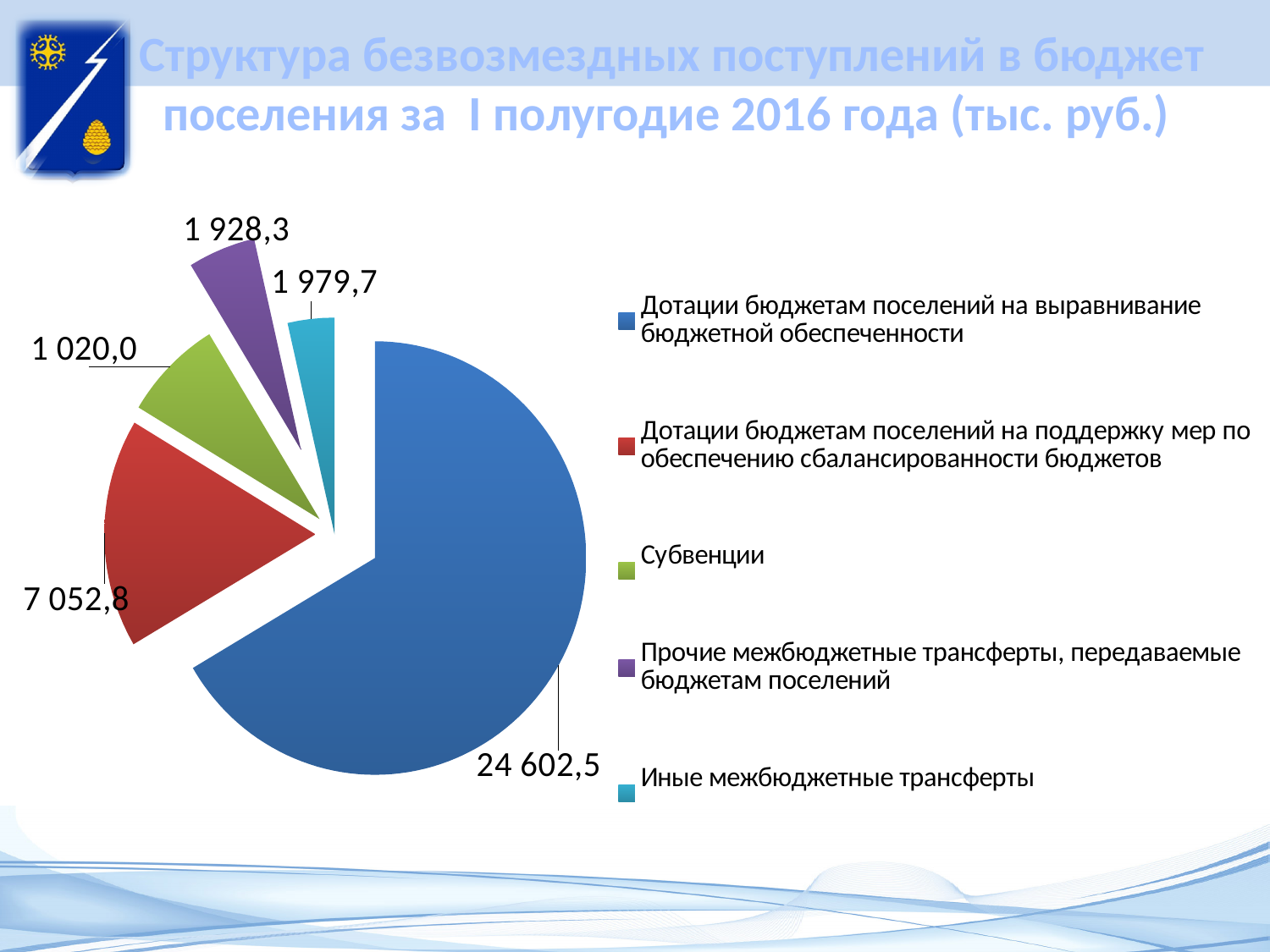
Which category has the largest slice of the pie? Дотации бюджетам поселений на выравнивание бюджетной обеспеченности What is the value for Дотации бюджетам поселений на поддержку мер по обеспечению сбалансированности бюджетов? 7 052,8 What is the value for Иные межбюджетные трансферты? 1 979,7 What colour is the slice for Субвенции? Green How many categories does the pie chart have? 5 What is the difference between the value for Дотации бюджетам поселений на выравнивание бюджетной обеспеченности and the value for Дотации бюджетам поселений на поддержку мер по обеспечению сбалансированности бюджетов? 17 549,7 What type of chart is shown on the slide? Pie chart Which is larger: the value for Иные межбюджетные трансферты or the value for Прочие межбюджетные трансферты, передаваемые бюджетам поселений? Иные межбюджетные трансферты What is the value for Прочие межбюджетные трансферты, передаваемые бюджетам поселений? 1 928,3 What is the value for Субвенции? 1 020,0 What is the value for Дотации бюджетам поселений на выравнивание бюджетной обеспеченности? 24 602,5